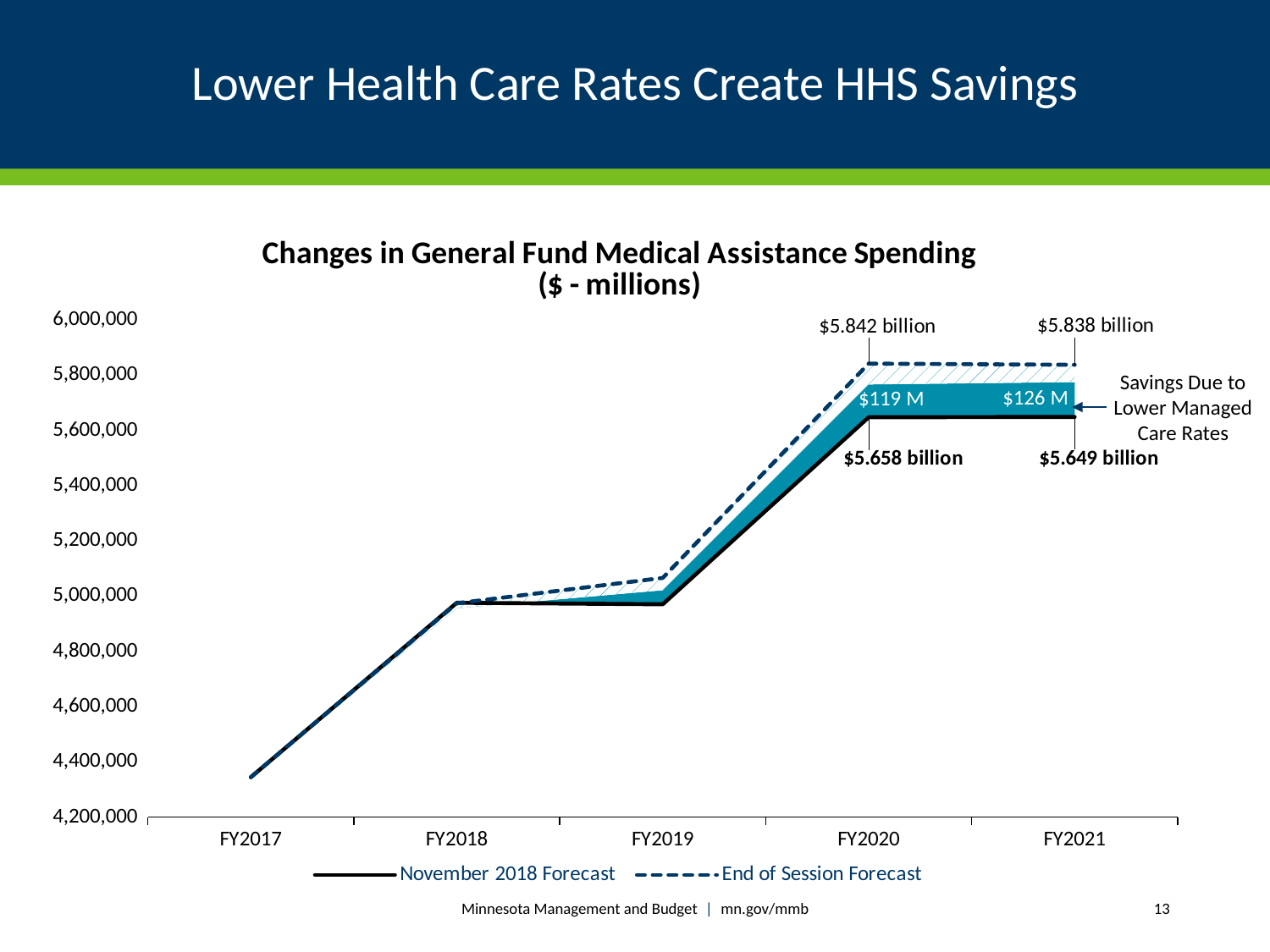
Does the November 2018 Forecast line rise or fall from FY2017 to FY2020? rise What type of chart is shown on the slide? line chart What are the savings due to lower managed care rates labeled for FY2020? $119 M What is the title of the chart? Changes in General Fund Medical Assistance Spending ($ - millions) What is the End of Session Forecast value for FY2020? $5.842 billion What are the savings due to lower managed care rates labeled for FY2021? $126 M How many series does the legend list? 2 What is the November 2018 Forecast value for FY2020? $5.658 billion Is the November 2018 Forecast value for FY2017 greater or less than 4,400,000? less What is the November 2018 Forecast value for FY2021? $5.649 billion What is the End of Session Forecast value for FY2021? $5.838 billion How many fiscal years are shown on the x axis? 5